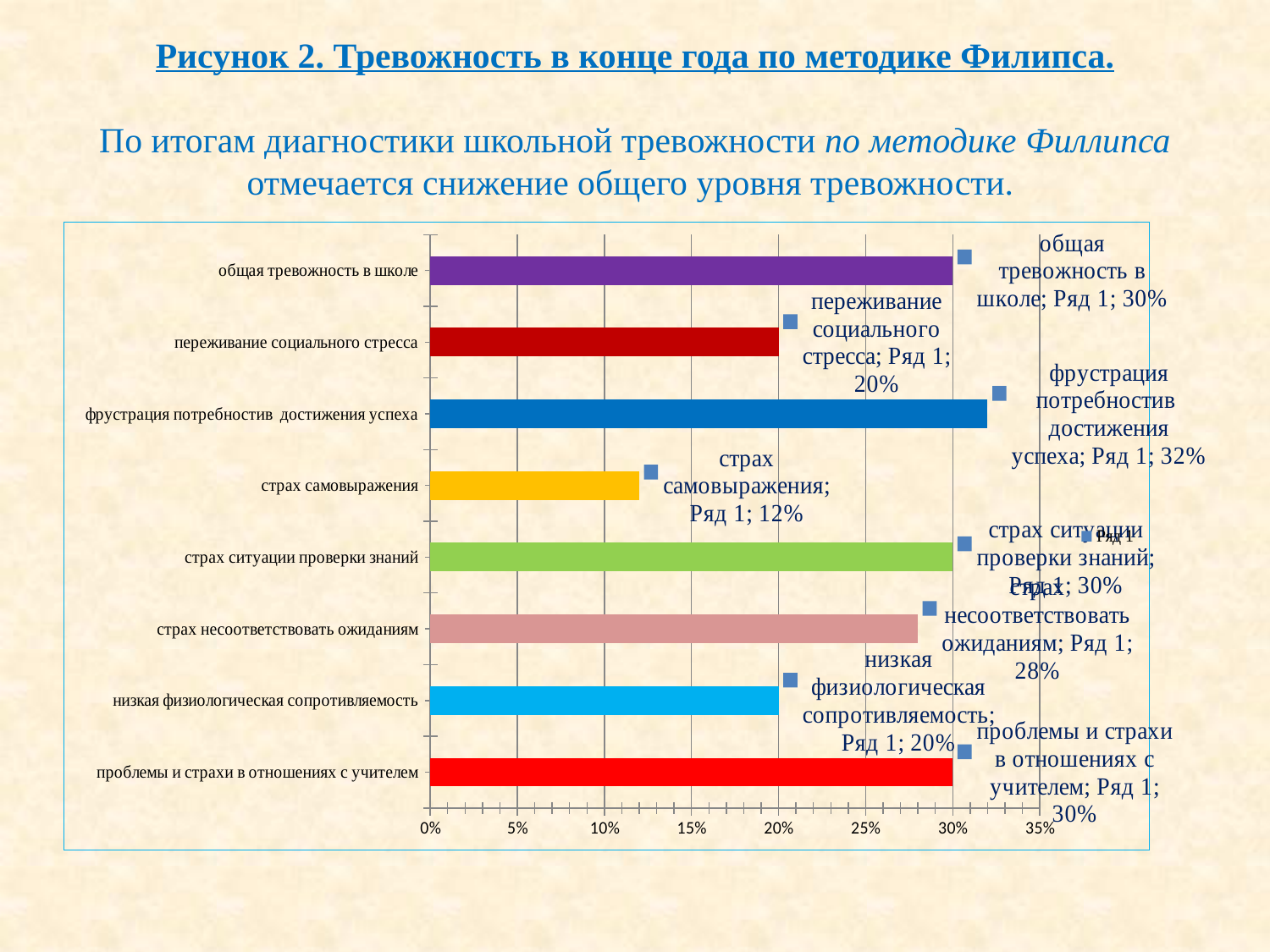
How many categories are plotted in the chart? 8 What is the name of the series shown in the legend? Ряд 1 What is the value for "общая тревожность в школе"? 30% What is the difference between the values for "фрустрация потребностив достижения успеха" and "страх самовыражения"? 20% What is the value for "страх несоответствовать ожиданиям"? 28% What is the value for "фрустрация потребностив достижения успеха"? 32% What kind of chart is shown on the slide? bar chart Which is larger: the value for "страх несоответствовать ожиданиям" or the value for "переживание социального стресса"? страх несоответствовать ожиданиям Which category has the highest value? фрустрация потребностив достижения успеха What is the value for "страх самовыражения"? 12% How many series does the legend list? 1 Which category has the lowest value? страх самовыражения